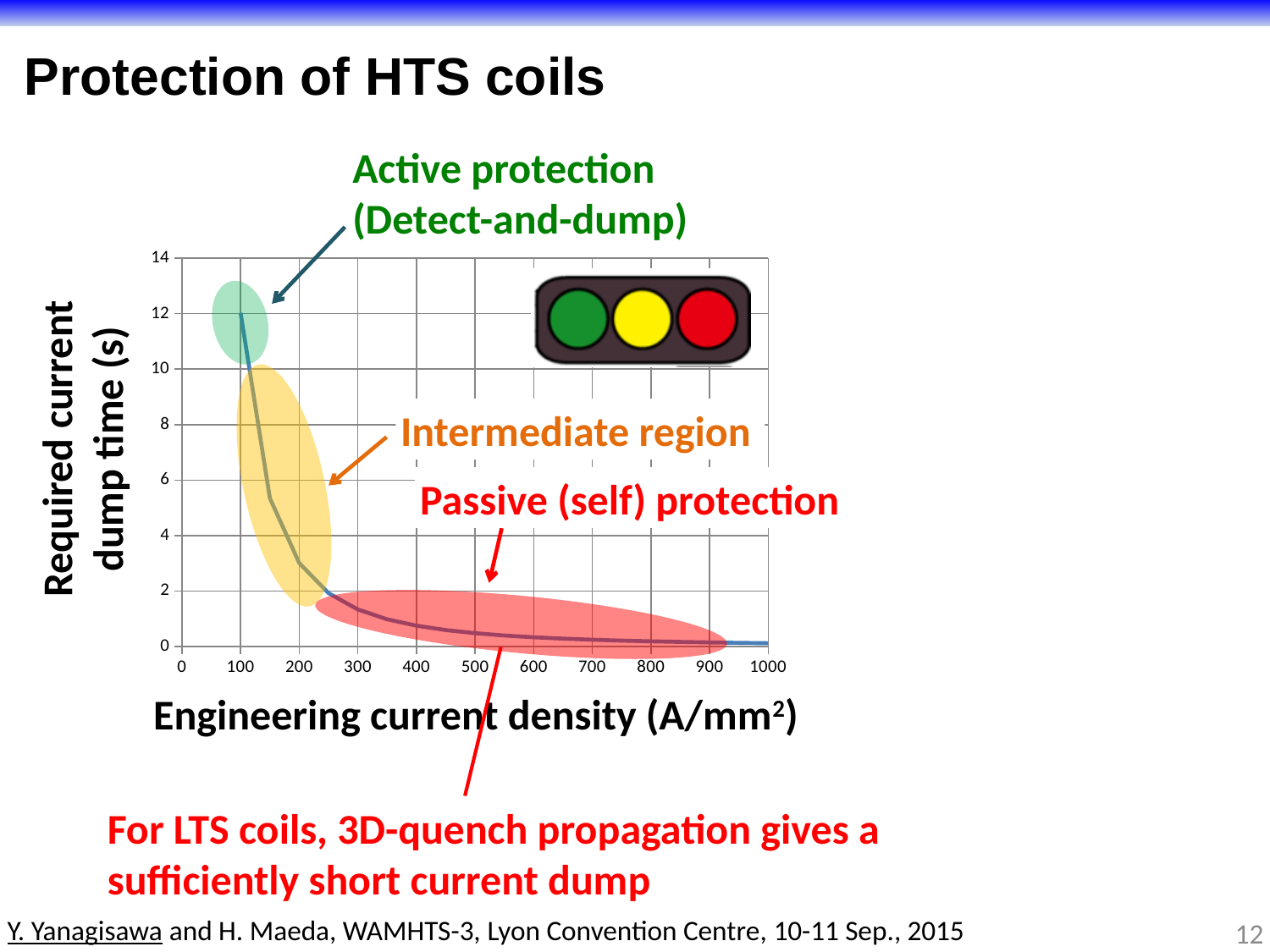
Is the required current dump time at an engineering current density of 100 A/mm² greater or less than 10 s? greater Which is larger, the required current dump time at 100 A/mm² or at 200 A/mm²? 100 A/mm² Is the required current dump time at an engineering current density of 900 A/mm² greater or less than 2 s? less Does the required current dump time rise or fall as engineering current density increases? fall Is the required current dump time at an engineering current density of 200 A/mm² greater or less than 4 s? less What is the label of the x axis of the chart? Engineering current density (A/mm²) What kind of chart is shown on the slide? line chart What is the maximum value shown on the x axis of the chart? 1000 What is the label of the y axis of the chart? Required current dump time (s)